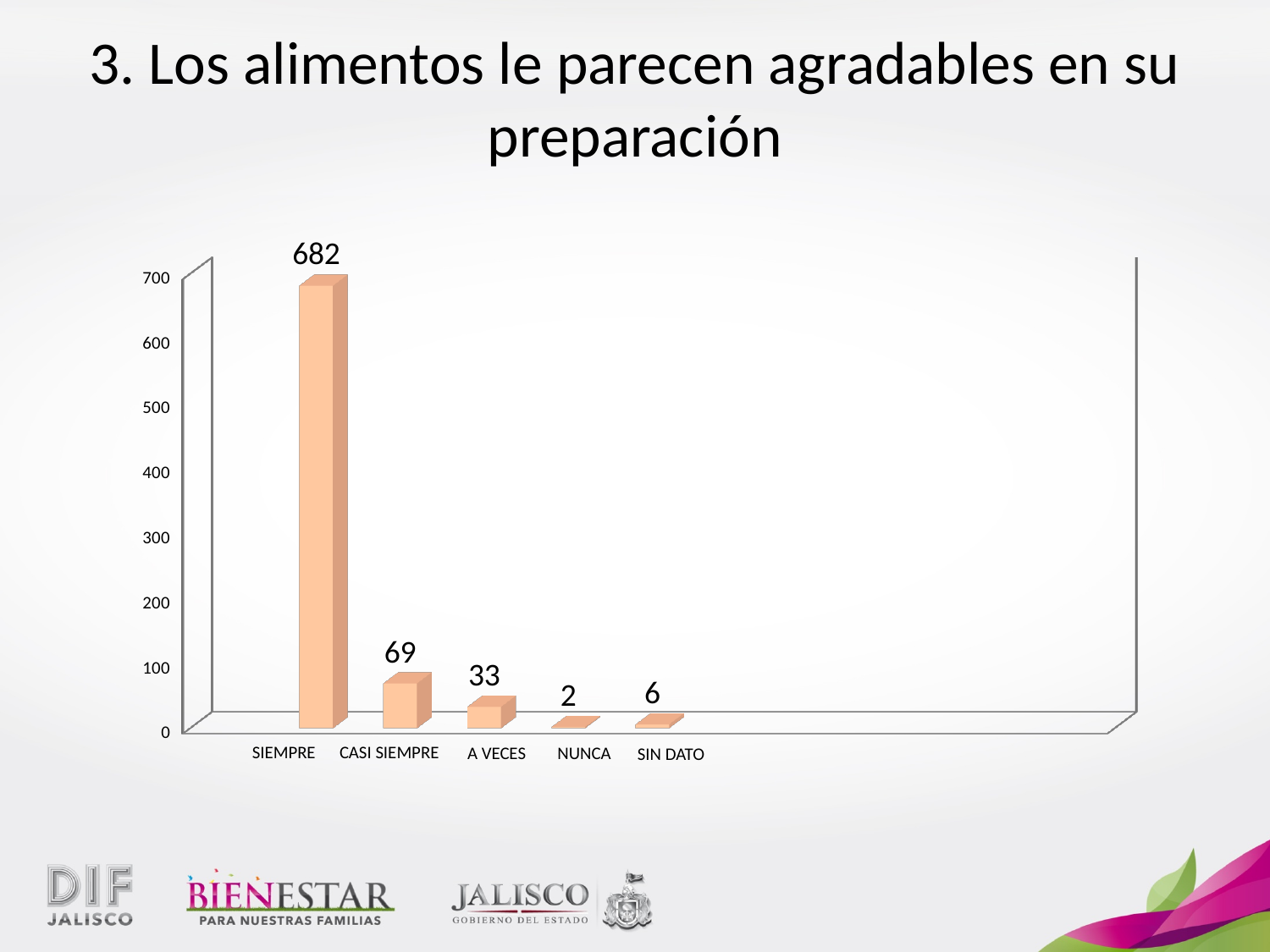
What is the value for CASI SIEMPRE? 69 What is the value for SIEMPRE? 682 What is the difference between the values for SIEMPRE and CASI SIEMPRE? 613 What is the title of the slide? 3. Los alimentos le parecen agradables en su preparación What is the value for NUNCA? 2 Which category has the lowest value? NUNCA Which category has the highest value? SIEMPRE Which is larger, the value for A VECES or the value for SIN DATO? A VECES What is the value for SIN DATO? 6 What is the value for A VECES? 33 What kind of chart is shown on the slide? Bar chart How many categories are shown on the x axis? 5